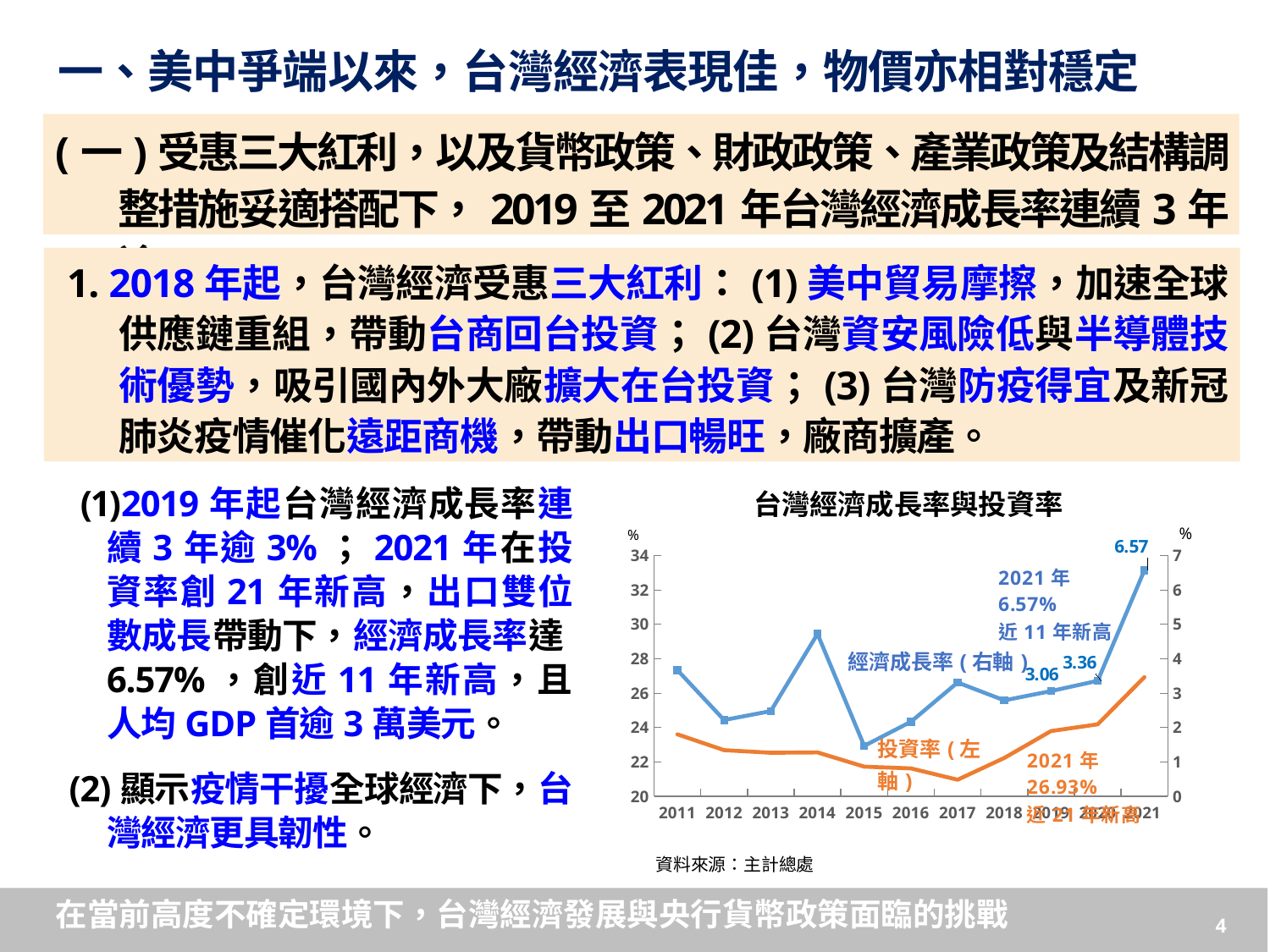
What is the difference between the economic growth rate in 2021 and in 2020? 3.21 What kind of chart is shown on the slide? line chart How many years are plotted on the x axis? 11 What is the economic growth rate (經濟成長率) shown for 2019? 3.06 Does the economic growth rate rise or fall from 2019 to 2021? rise In which year is the investment rate (投資率) lowest? 2017 Is the investment rate (投資率) for 2017 greater or less than 22? less Which year has the higher economic growth rate, 2019 or 2020? 2020 How many series does the chart show? 2 What is the investment rate (投資率) shown for 2021? 26.93% In which year is the economic growth rate (經濟成長率) highest? 2021 What is the economic growth rate (經濟成長率) shown for 2021? 6.57